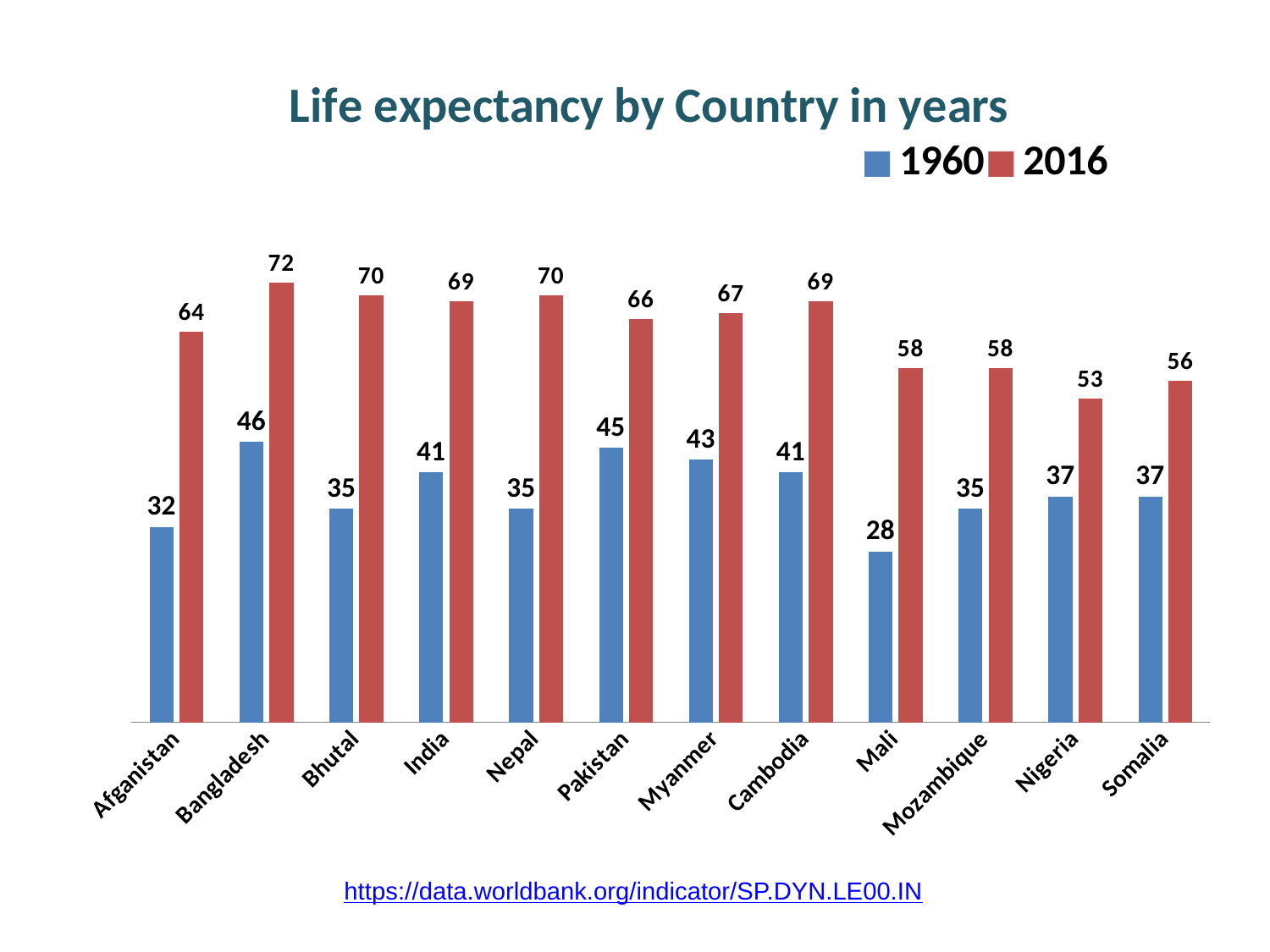
What was the life expectancy in Afganistan in 1960? 32 How many series does the legend list? 2 Which country had the highest life expectancy in 2016? Bangladesh Which country had the lowest life expectancy in 2016? Nigeria How many countries are shown on the chart? 12 What was the life expectancy in Mali in 1960? 28 What is the difference between Nepal's life expectancy in 2016 and in 1960? 35 Which colour represents the year 2016 in the chart? Red What was the life expectancy in Bangladesh in 2016? 72 Which had a higher life expectancy in 1960, Pakistan or Myanmer? Pakistan Which country had the lowest life expectancy in 1960? Mali What kind of chart is shown on the slide? Bar chart